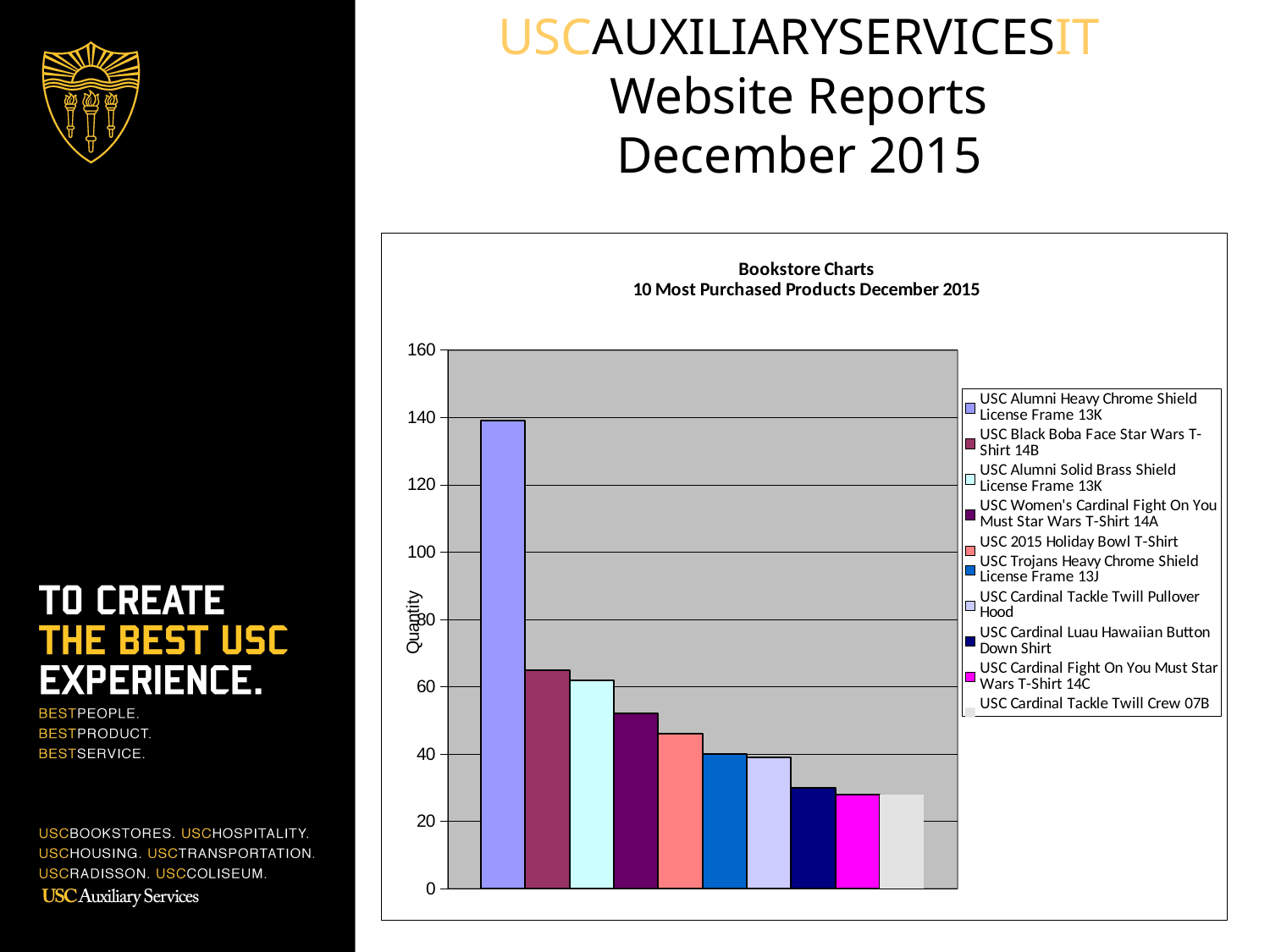
What is the label on the vertical axis of the chart? Quantity How many bars are plotted in the chart? 10 Is the value for USC Women's Cardinal Fight On You Must Star Wars T-Shirt 14A greater or less than 60? less What is the title of the chart? Bookstore Charts 10 Most Purchased Products December 2015 How many series does the legend list? 10 Is the value for USC Black Boba Face Star Wars T-Shirt 14B greater or less than 60? greater Do the bar values rise or fall from left to right across the chart? fall Is the value for USC 2015 Holiday Bowl T-Shirt greater or less than 40? greater Which is larger, the value for USC Black Boba Face Star Wars T-Shirt 14B or the value for USC 2015 Holiday Bowl T-Shirt? USC Black Boba Face Star Wars T-Shirt 14B What kind of chart is shown on the slide? bar chart Which product has the highest quantity in the chart? USC Alumni Heavy Chrome Shield License Frame 13K